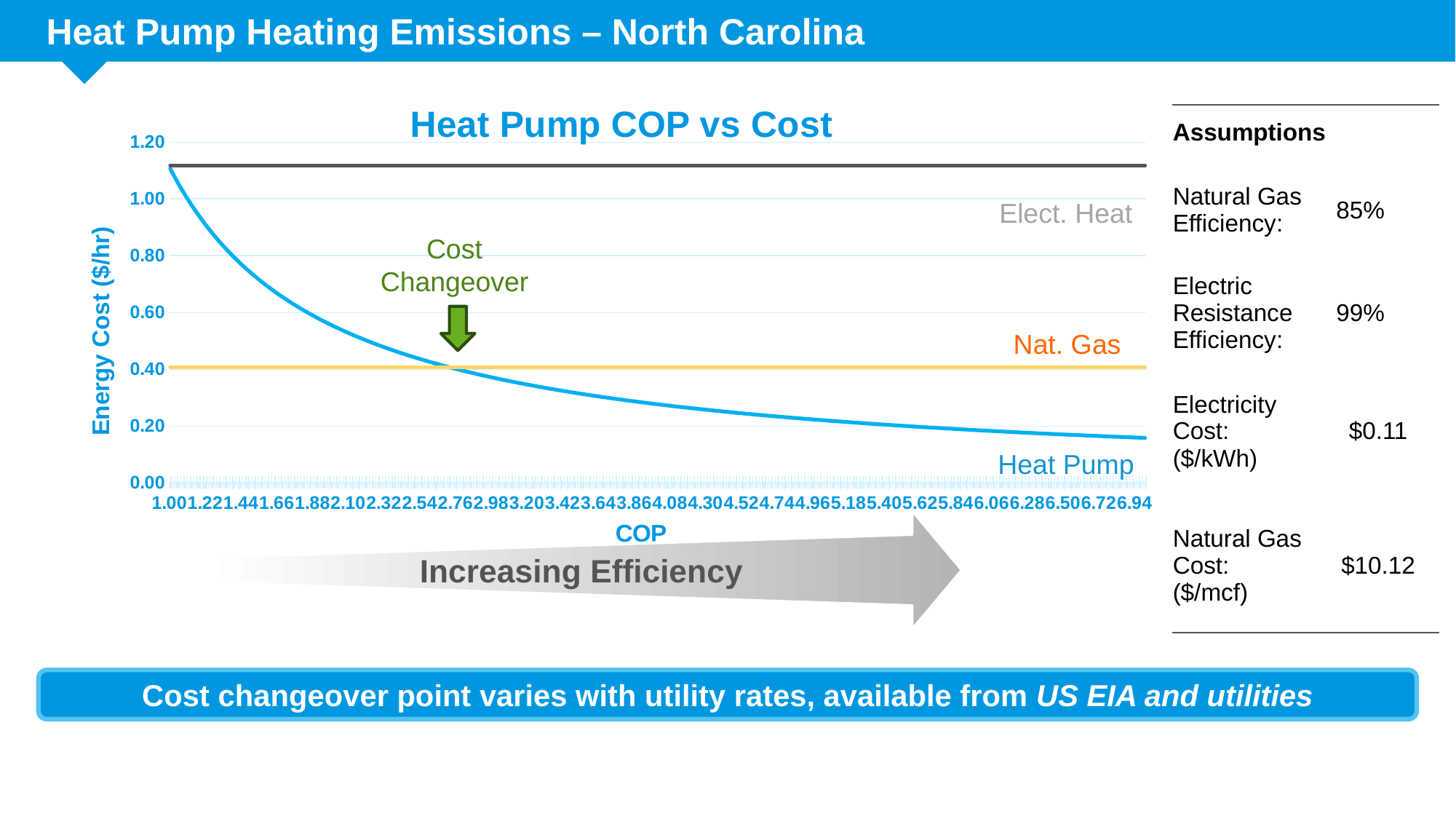
Is the Heat Pump value at COP 1.00 greater or less than 0.80? greater At COP 1.00, which is higher, the Heat Pump cost or the Nat. Gas cost? Heat Pump Is the Heat Pump value at COP 6.94 greater or less than 0.20? less Which of the three lines has the lowest energy cost at COP 6.94? Heat Pump Is the value of the Nat. Gas line greater or less than 0.60? less What is the title of the chart? Heat Pump COP vs Cost How many series (lines) are plotted on the chart? 3 What is the label on the vertical axis of the chart? Energy Cost ($/hr) What kind of chart is shown on the slide? Line chart Does the Heat Pump line rise or fall as COP increases along the x axis? Fall Which line has the higher energy cost, Elect. Heat or Nat. Gas? Elect. Heat